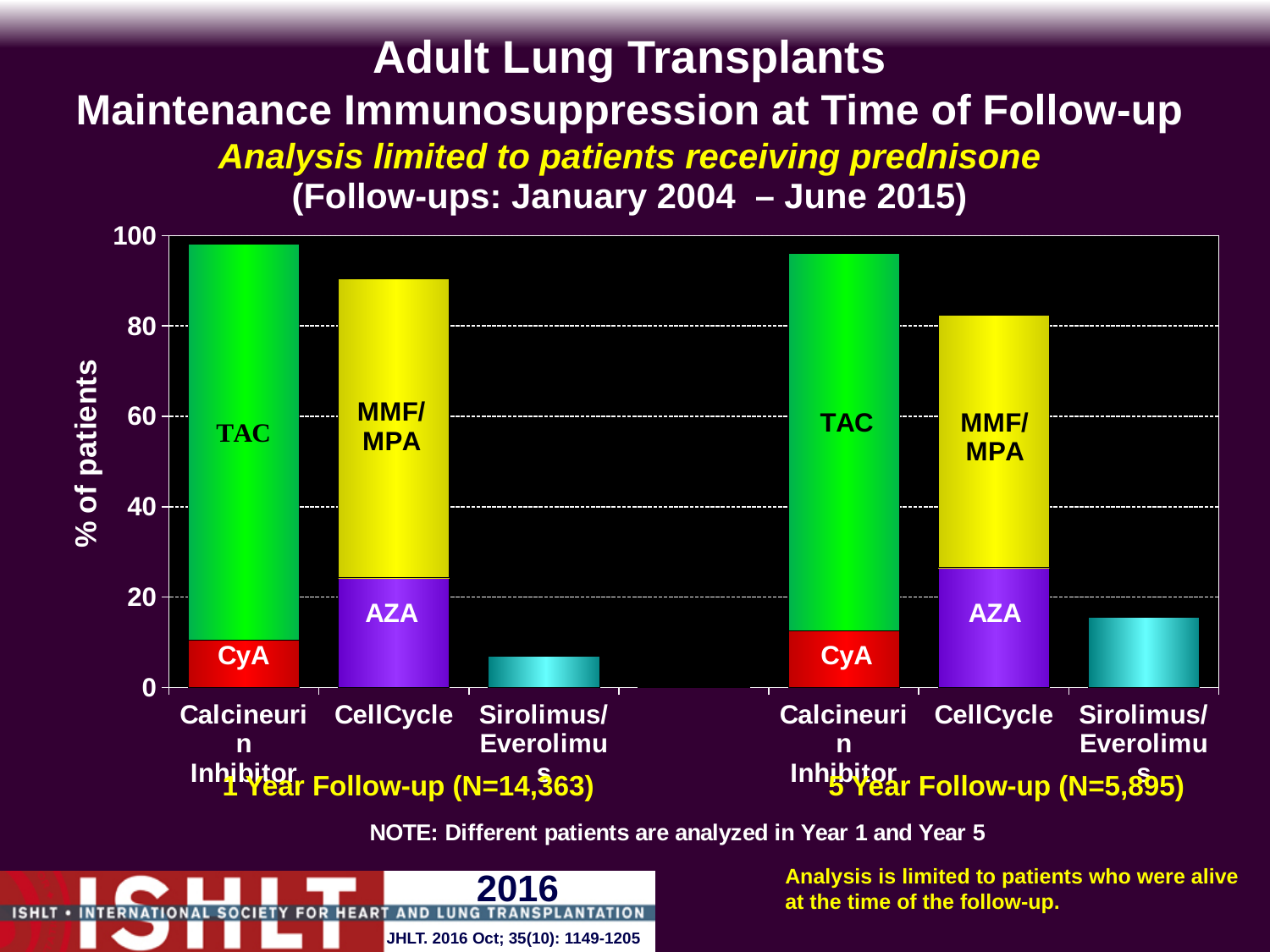
Is the value for Sirolimus/Everolimus at 1 Year Follow-up greater or less than 20? less Which is larger: the Sirolimus/Everolimus bar at 1 Year Follow-up or at 5 Year Follow-up? 5 Year Follow-up In the 1 Year Follow-up group, which category has the tallest bar? Calcineurin Inhibitor Which is larger: the CellCycle bar at 1 Year Follow-up or at 5 Year Follow-up? 1 Year Follow-up What kind of chart is shown on the slide? Stacked bar chart Is the total value for CellCycle at 5 Year Follow-up greater or less than 60? greater What is the label of the y-axis? % of patients Is the CyA segment at 1 Year Follow-up greater or less than 20? less In the 5 Year Follow-up group, which category has the shortest bar? Sirolimus/Everolimus How many drug categories are shown for the 1 Year Follow-up group? 3 What is the N for the 5 Year Follow-up group? 5,895